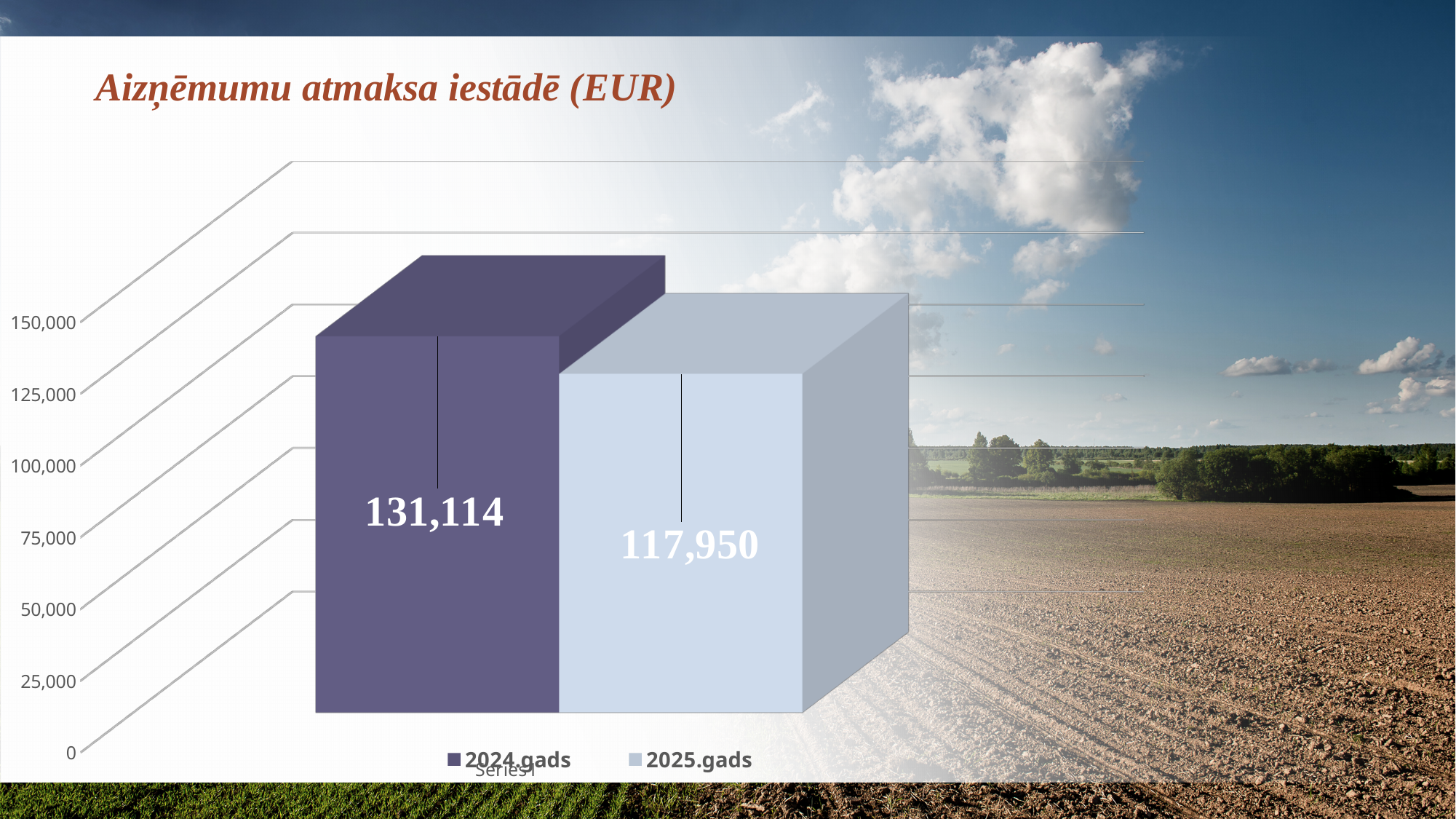
Is the value for 2024.gads greater or less than 125,000? greater What is the value for 2025.gads? 117,950 Is the value for 2025.gads greater or less than 125,000? less How many series does the legend list? 2 What is the highest value shown on the vertical axis? 150,000 Which series has the higher value, 2024.gads or 2025.gads? 2024.gads Which series has the lowest value? 2025.gads What is the title of the chart? Aizņēmumu atmaksa iestādē (EUR) What is the difference between the 2024.gads value and the 2025.gads value? 13,164 What is the value for 2024.gads? 131,114 Which series has the highest value? 2024.gads What kind of chart is shown on the slide? bar chart